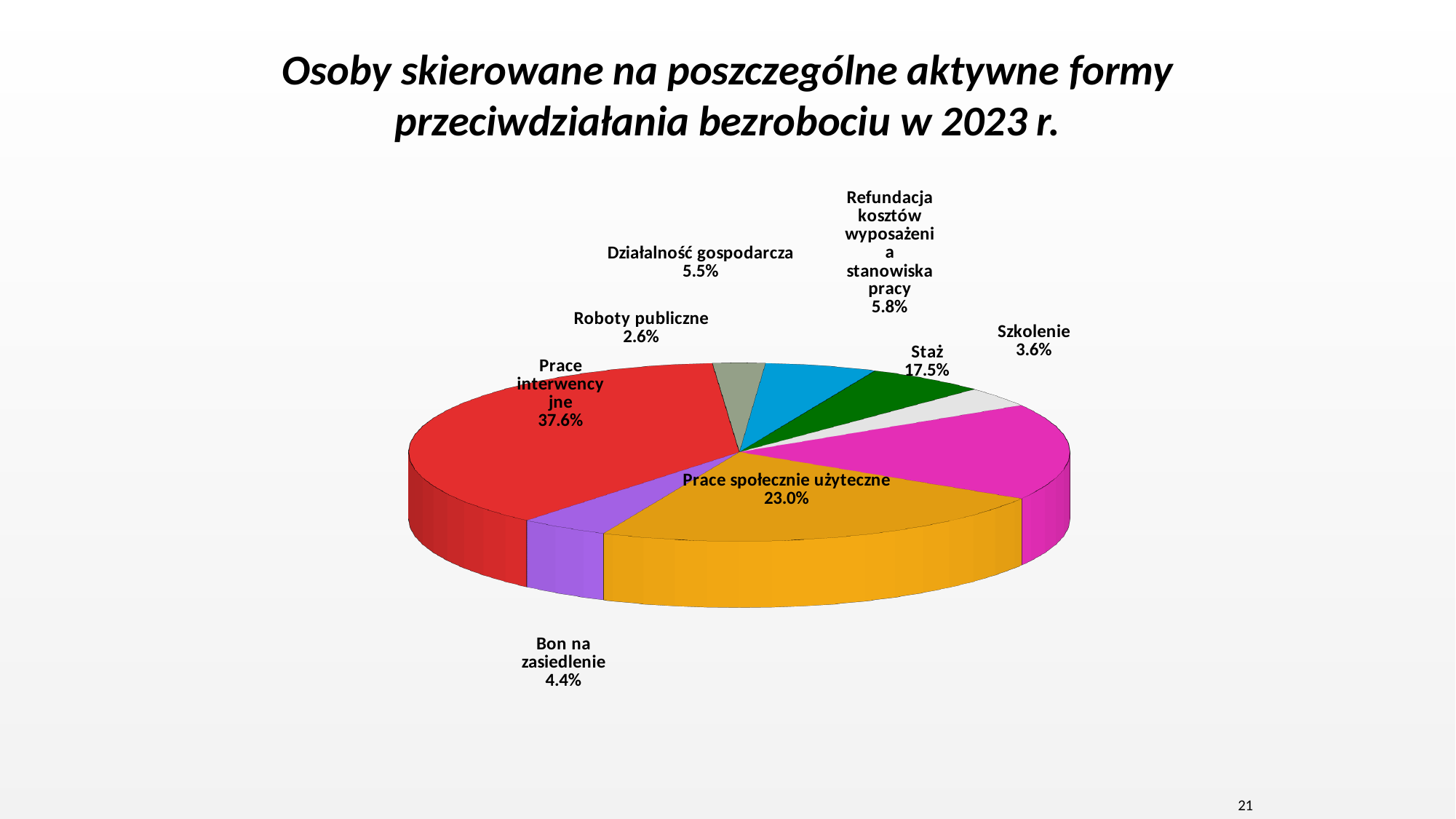
What share of the pie does Prace społecznie użyteczne have? 23.0% What is the value shown for Staż? 17.5% What kind of chart is shown on the slide? Pie chart Which category has the smallest share of the pie? Roboty publiczne What is the value shown for Refundacja kosztów wyposażenia stanowiska pracy? 5.8% Which is larger, the share for Szkolenie or the share for Działalność gospodarcza? Działalność gospodarcza What is the title of the chart? Osoby skierowane na poszczególne aktywne formy przeciwdziałania bezrobociu w 2023 r. Which category has the largest share of the pie? Prace interwencyjne How many categories are shown in the pie chart? 8 What is the difference between the shares of Prace interwencyjne and Prace społecznie użyteczne? 14.6% What share of the pie does Prace interwencyjne have? 37.6% What is the value shown for Bon na zasiedlenie? 4.4%